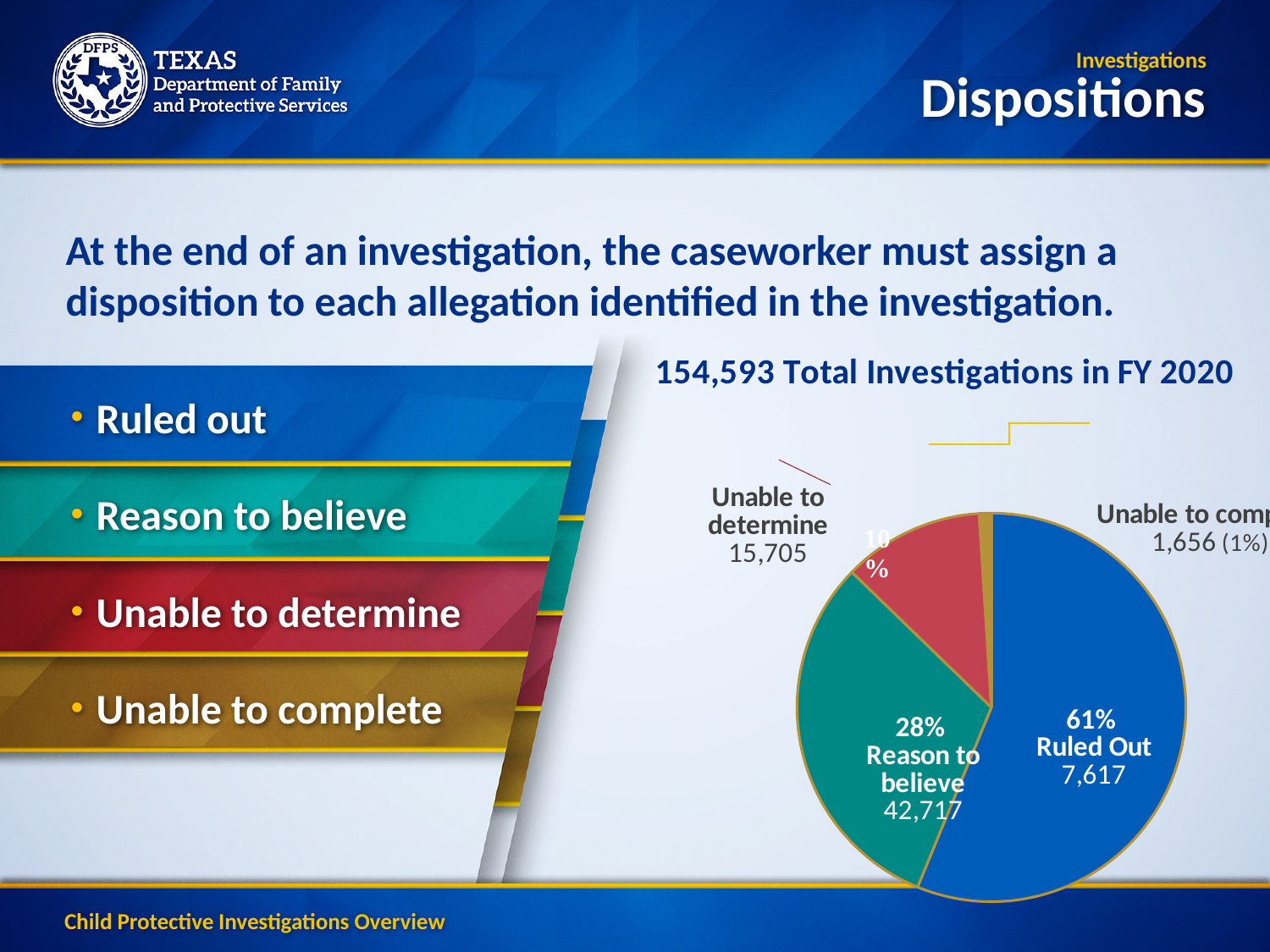
How many slices does the pie chart have? 4 What share of the pie is Unable to determine? 10% What share of the pie is Ruled Out? 61% What kind of chart is shown on the slide? pie chart What is the title of the chart? 154,593 Total Investigations in FY 2020 Which disposition has the smallest slice of the pie? Unable to complete Which has the larger share of the pie, Reason to believe or Unable to determine? Reason to believe What value is printed for Unable to determine? 15,705 What value is printed for Reason to believe? 42,717 What value is printed for Ruled Out? 7,617 Which disposition has the largest slice of the pie? Ruled Out What share of the pie is Reason to believe? 28%